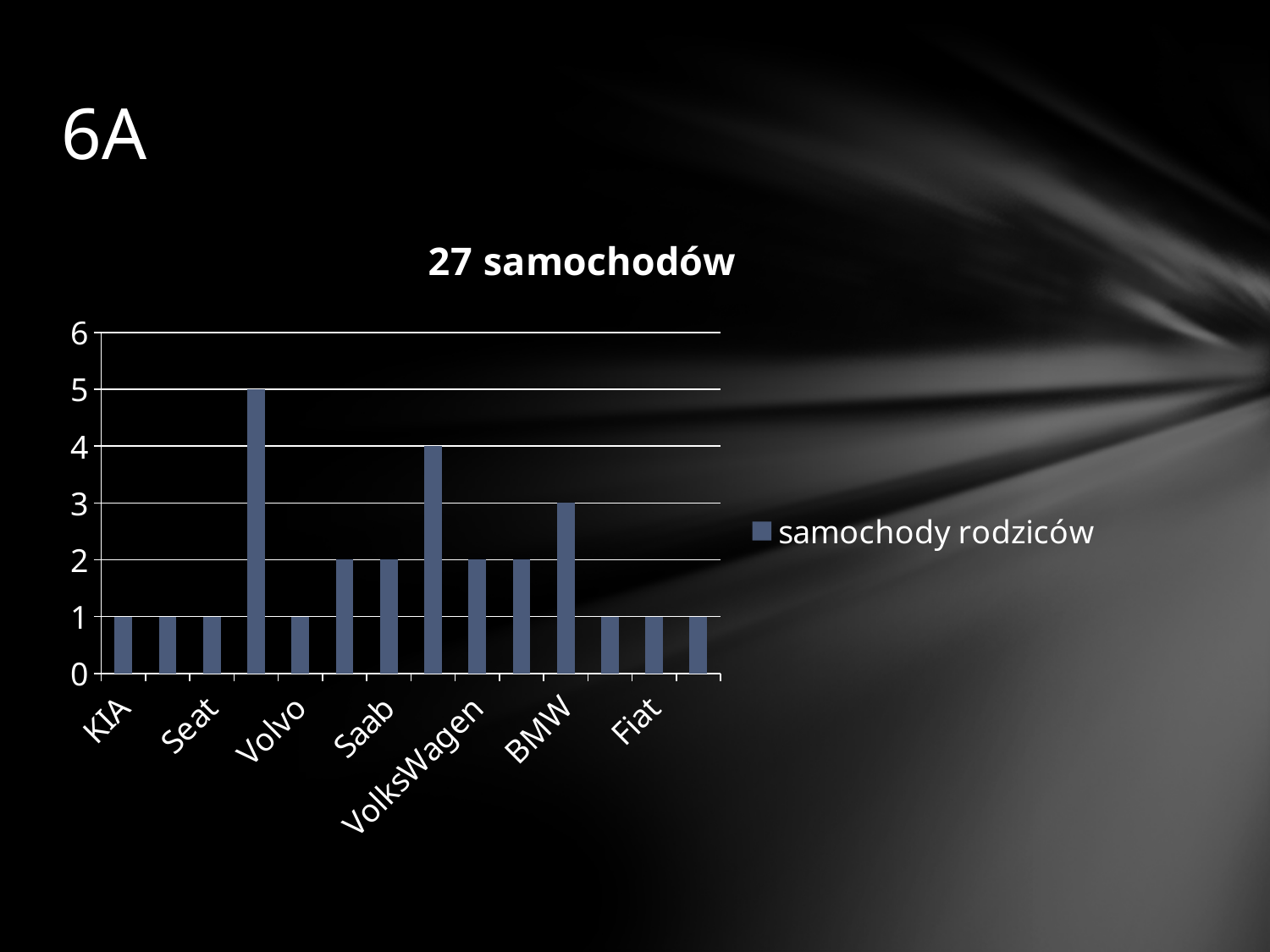
What is the name of the series shown in the legend? samochody rodziców Which has a larger value, BMW or Fiat? BMW What is the difference between the values for BMW and Volvo? 2 What is the title of the chart? 27 samochodów What is the value for Saab? 2 How many bars are plotted in the chart? 14 What is the value of the tallest bar in the chart? 5 What kind of chart is shown on the slide? bar chart What is the value for BMW? 3 How many series does the legend list? 1 What is the value for VolksWagen? 2 What is the value for KIA? 1